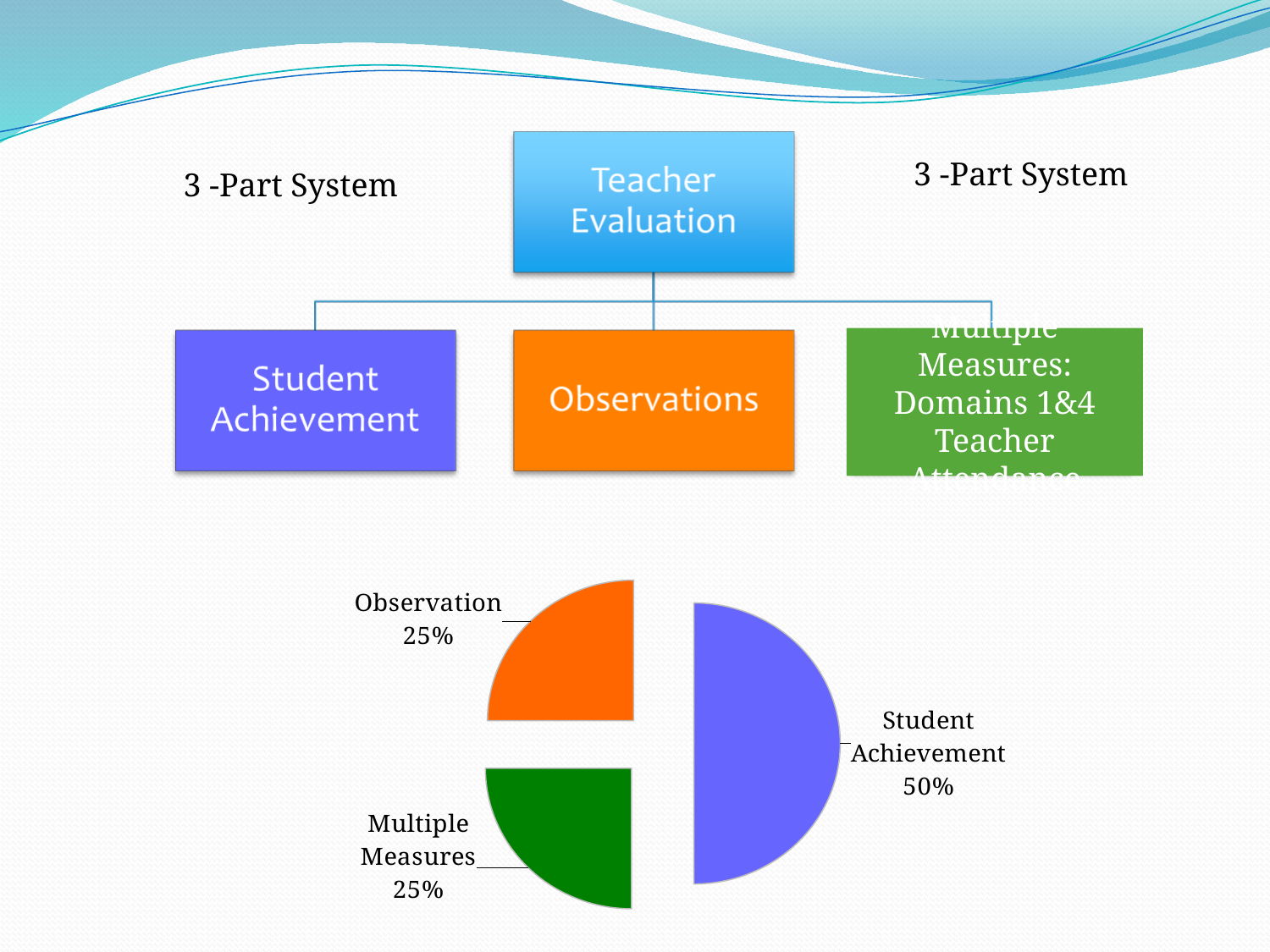
What colour is the Multiple Measures slice in the pie chart? Green What percentage is shown for Observation in the pie chart? 25% Which slice of the pie chart is the largest? Student Achievement What percentage is shown for Multiple Measures in the pie chart? 25% What do the three slices of the pie chart add up to? 100% What kind of chart is shown at the bottom of the slide? Pie chart What colour is the Student Achievement slice in the pie chart? Blue/purple What is the difference between the Student Achievement share and the Multiple Measures share in the pie chart? 25% Which is larger in the pie chart, Student Achievement or Observation? Student Achievement How many slices does the pie chart have? 3 What share of the pie chart does Student Achievement represent? 50%